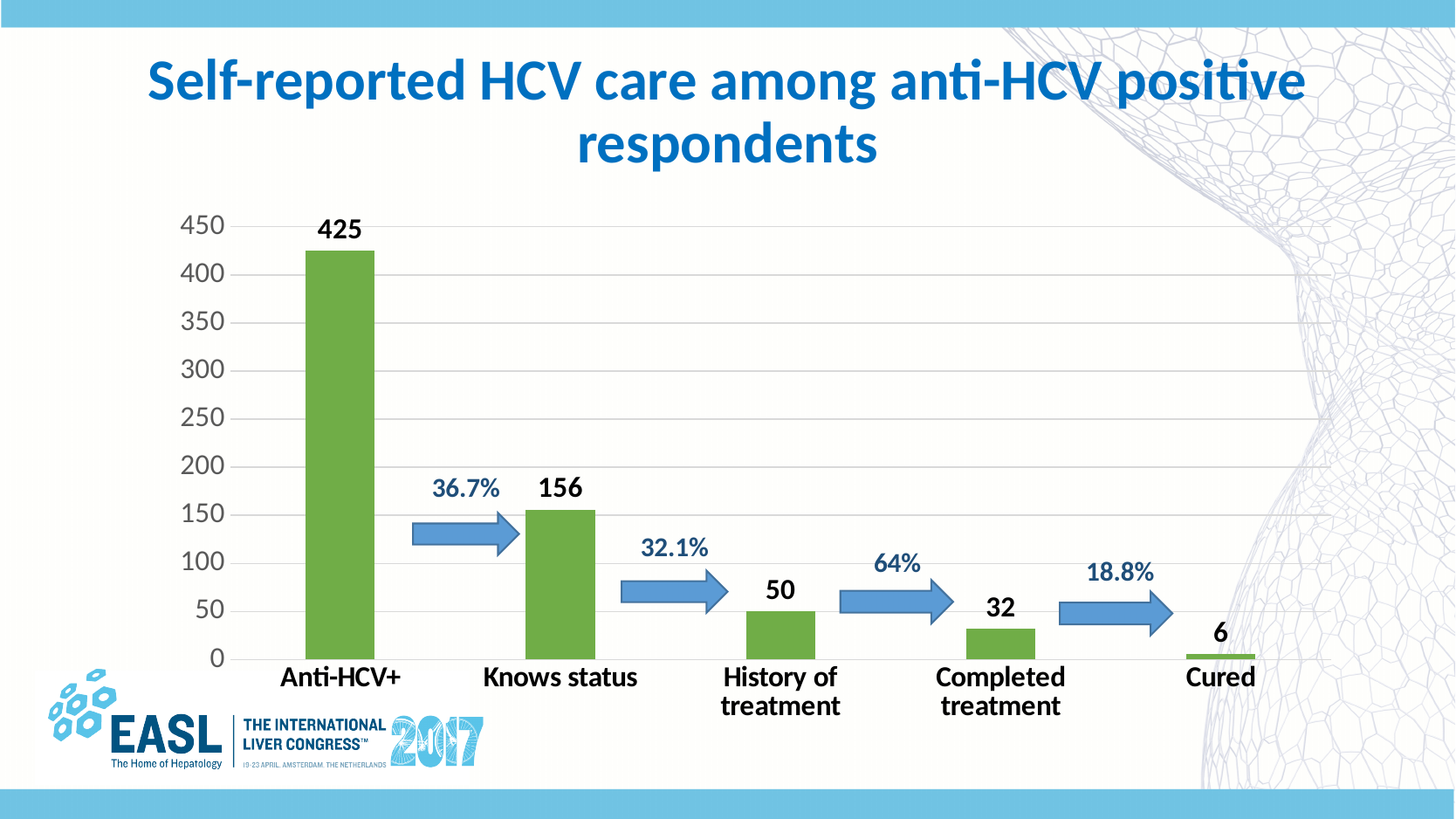
What is the difference between the values for Anti-HCV+ and Knows status? 269 What is the value for History of treatment? 50 Which category has the highest value? Anti-HCV+ What is the value for Cured? 6 How many categories are shown on the x axis? 5 What is the difference between the values for History of treatment and Completed treatment? 18 Which is larger, the value for Knows status or the value for History of treatment? Knows status What is the value for Completed treatment? 32 What is the value for Knows status? 156 What is the value for Anti-HCV+? 425 Which category has the lowest value? Cured What kind of chart is shown on the slide? Bar chart